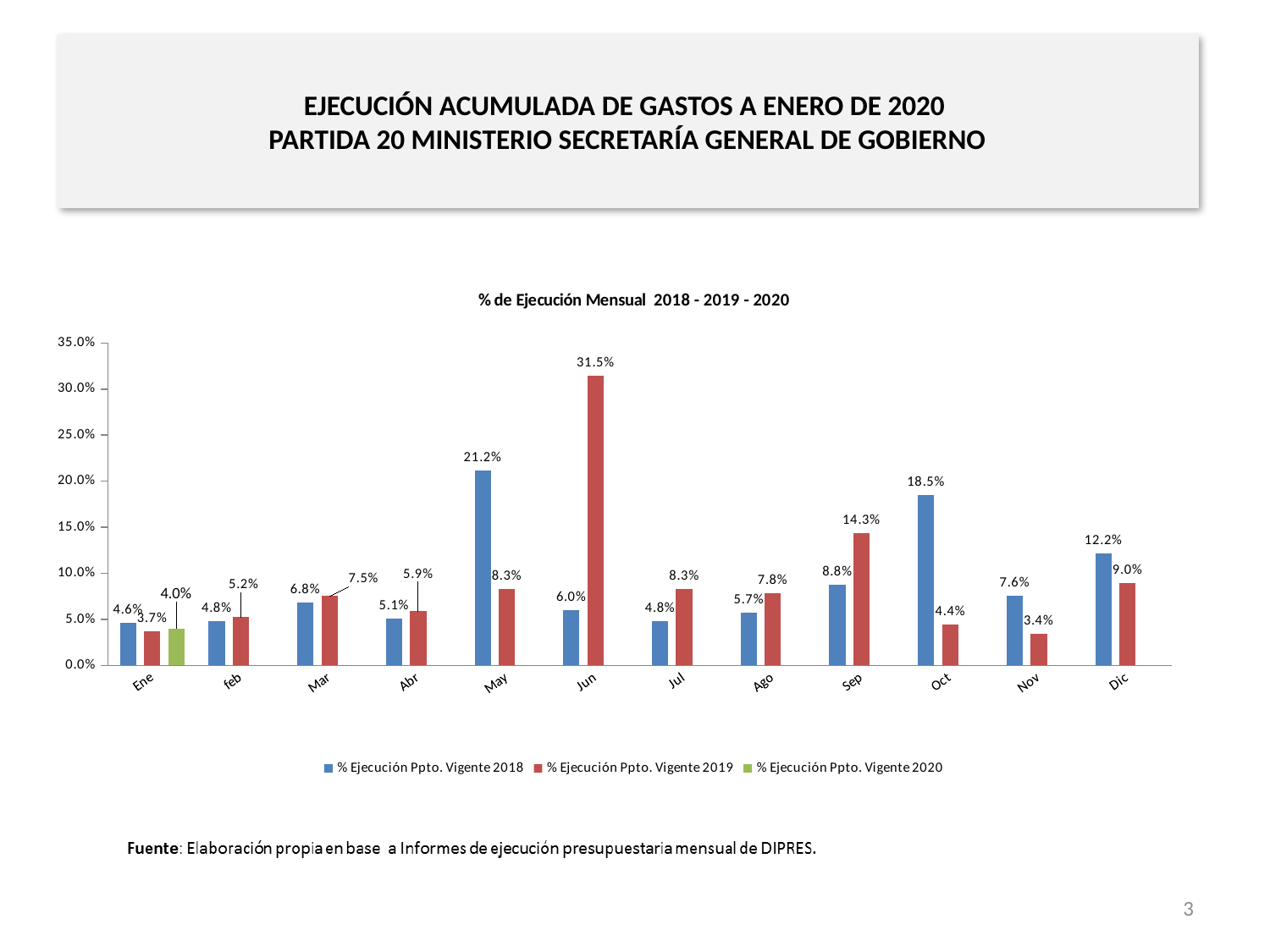
What is the value for Ene in the % Ejecución Ppto. Vigente 2020 series? 4.0% How many months are shown on the x axis? 12 How many series does the legend list? 3 What is the difference between the 2019 and 2018 values for Jun? 25.5% What is the value for Jun in the % Ejecución Ppto. Vigente 2019 series? 31.5% What is the title of the chart? % de Ejecución Mensual 2018 - 2019 - 2020 Is the value for Sep in the 2019 series greater or less than 10.0%? greater What is the value for May in the % Ejecución Ppto. Vigente 2018 series? 21.2% Which month has the lowest value in the % Ejecución Ppto. Vigente 2019 series? Nov For Oct, which series has the larger value, 2018 or 2019? 2018 Which month has the highest value in the % Ejecución Ppto. Vigente 2018 series? May What kind of chart is shown on the slide? bar chart